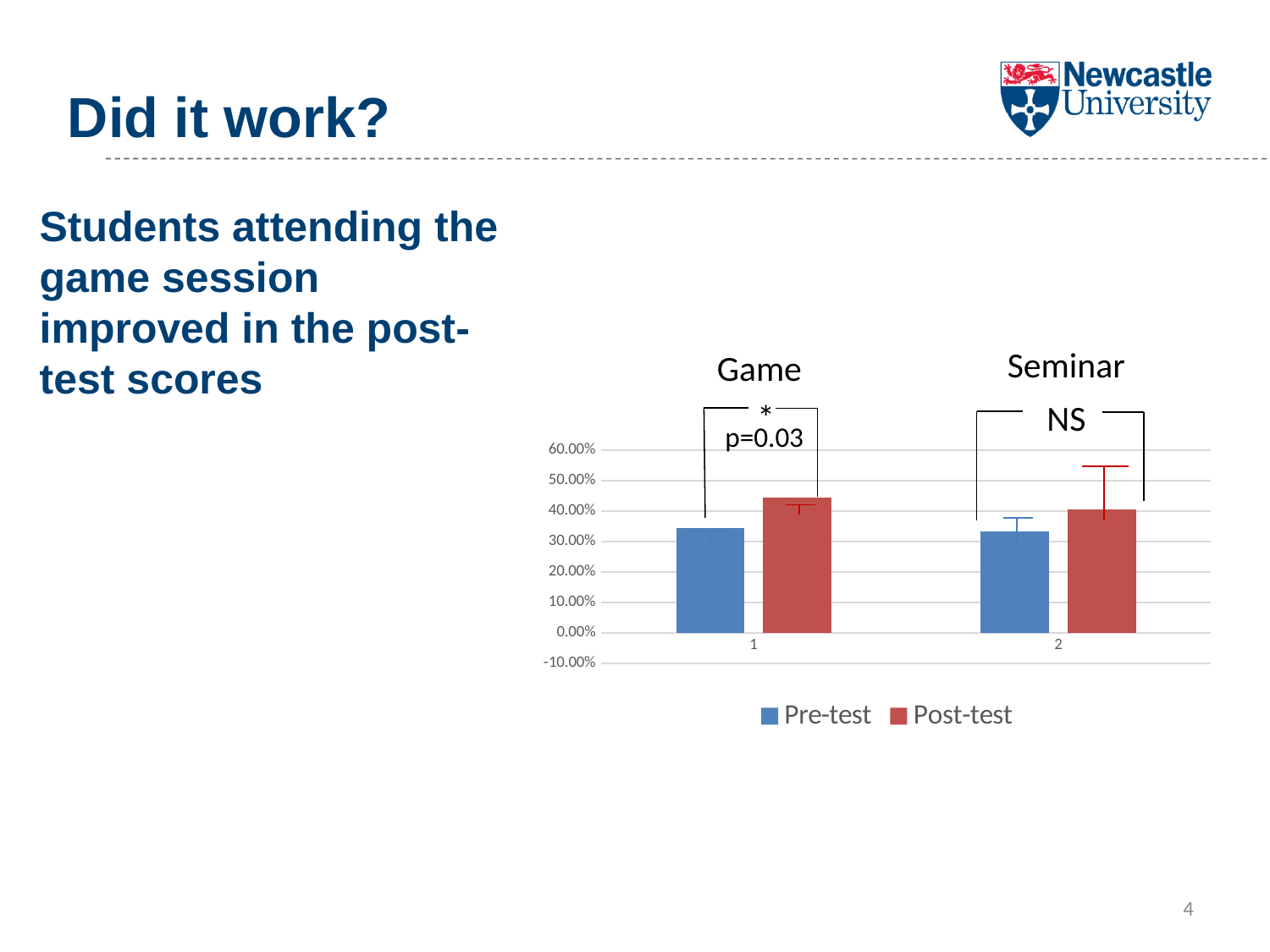
How many series does the chart legend list? 2 Which group of bars is labelled with the p-value p=0.03? Game Is the Post-test value for the Game group greater or less than 50.00%? less Is the Post-test value for the Seminar group greater or less than 30.00%? greater How many groups of bars are plotted on the x axis? 2 Is the Pre-test value for the Game group greater or less than 30.00%? greater For the Game group, which is larger, the Pre-test bar or the Post-test bar? Post-test What are the two series named in the chart legend? Pre-test and Post-test For the Seminar group, which is larger, the Pre-test bar or the Post-test bar? Post-test What kind of chart is shown on the slide? bar chart